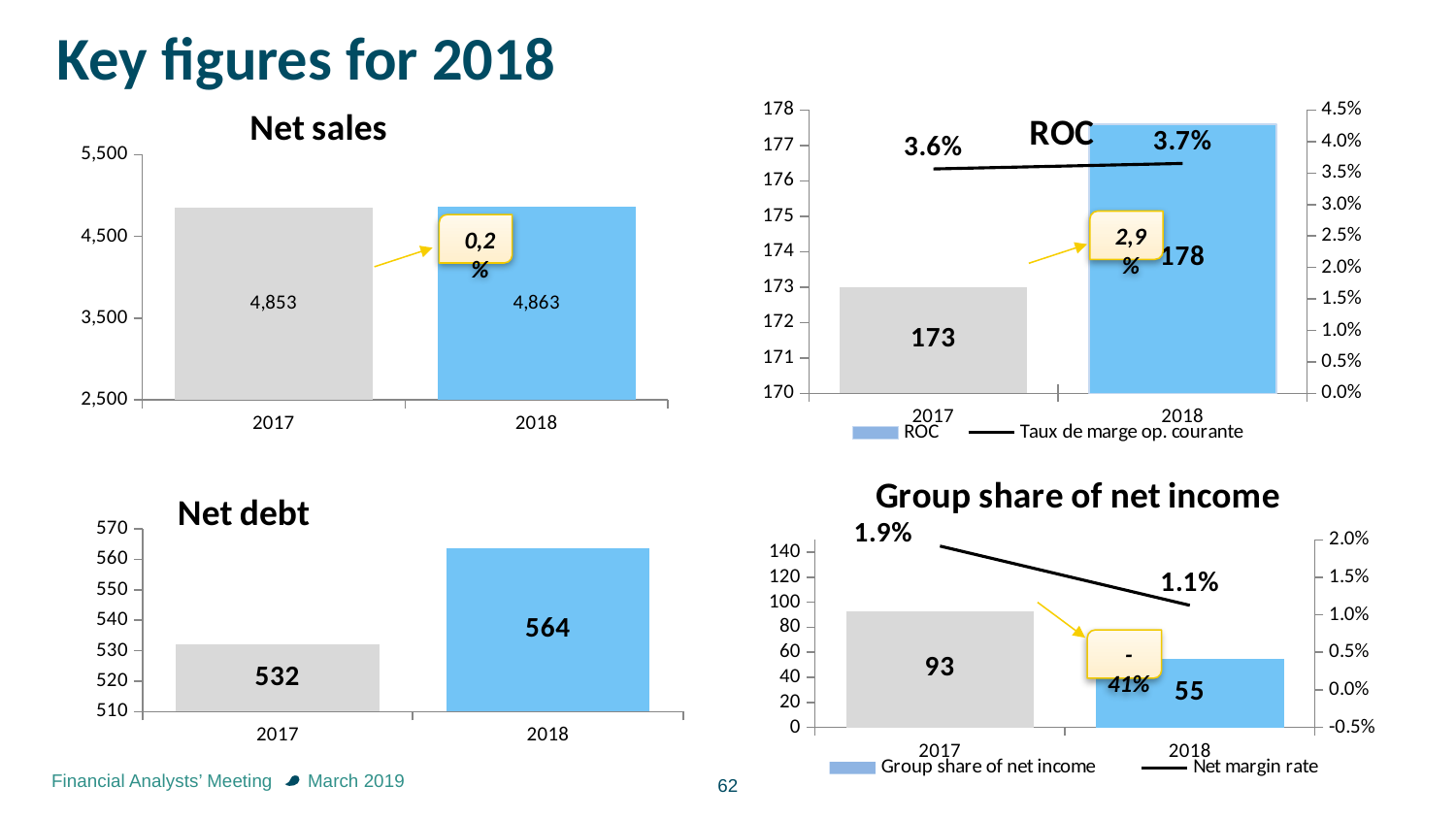
In the Group share of net income chart, does the Net margin rate rise or fall from 2017 to 2018? fall In the ROC chart, what is the Taux de marge op. courante value for 2017? 3.6% In the Group share of net income chart, what is the difference between the 2017 and 2018 Group share of net income values? 38 In the Group share of net income chart, what is the Group share of net income value for 2018? 55 In the Net sales chart, what is the value for 2017? 4,853 How many series does the legend of the ROC chart list? 2 In the Net debt chart, what is the difference between the 2018 and 2017 values? 32 What kind of chart is the Net sales chart? bar chart In the ROC chart, what is the ROC value for 2018? 178 How many categories are shown on the x axis of the Net debt chart? 2 In the Net sales chart, what is the difference between the 2018 and 2017 values? 10 In the Net debt chart, which year has the higher value? 2018